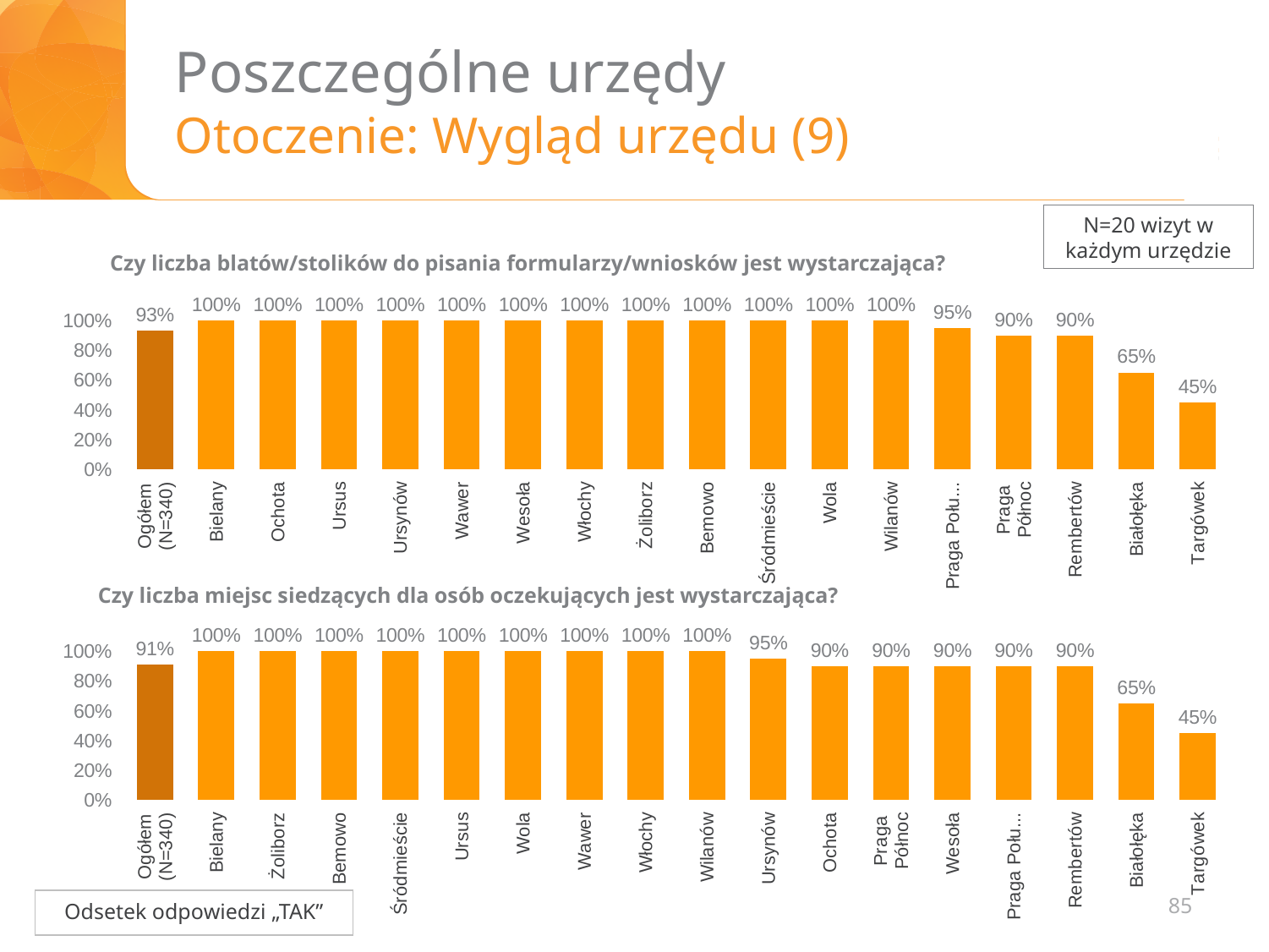
In the top chart (Czy liczba blatów/stolików...), what is the difference between the values for Praga Północ and Targówek? 45% In the bottom chart (Czy liczba miejsc siedzących...), what is the value for Ursynów? 95% What type of chart is the bottom chart (Czy liczba miejsc siedzących...)? Bar chart How many categories (bars) are shown in the top chart (Czy liczba blatów/stolików...)? 18 In the top chart (Czy liczba blatów/stolików...), which category has the lowest value? Targówek In the bottom chart (Czy liczba miejsc siedzących...), what is the difference between the values for Białołęka and Targówek? 20% In the bottom chart (Czy liczba miejsc siedzących...), what is the value for Ochota? 90% In the bottom chart (Czy liczba miejsc siedzących...), is the value for Targówek greater or less than 60%? less In the top chart (Czy liczba blatów/stolików...), which is larger: the value for Wilanów or the value for Rembertów? Wilanów In the bottom chart (Czy liczba miejsc siedzących dla osób oczekujących jest wystarczająca?), what is the value for Ogółem (N=340)? 91% In the top chart (Czy liczba blatów/stolików do pisania formularzy/wniosków jest wystarczająca?), what is the value for Ogółem (N=340)? 93% In the top chart (Czy liczba blatów/stolików...), what is the value for Białołęka? 65%